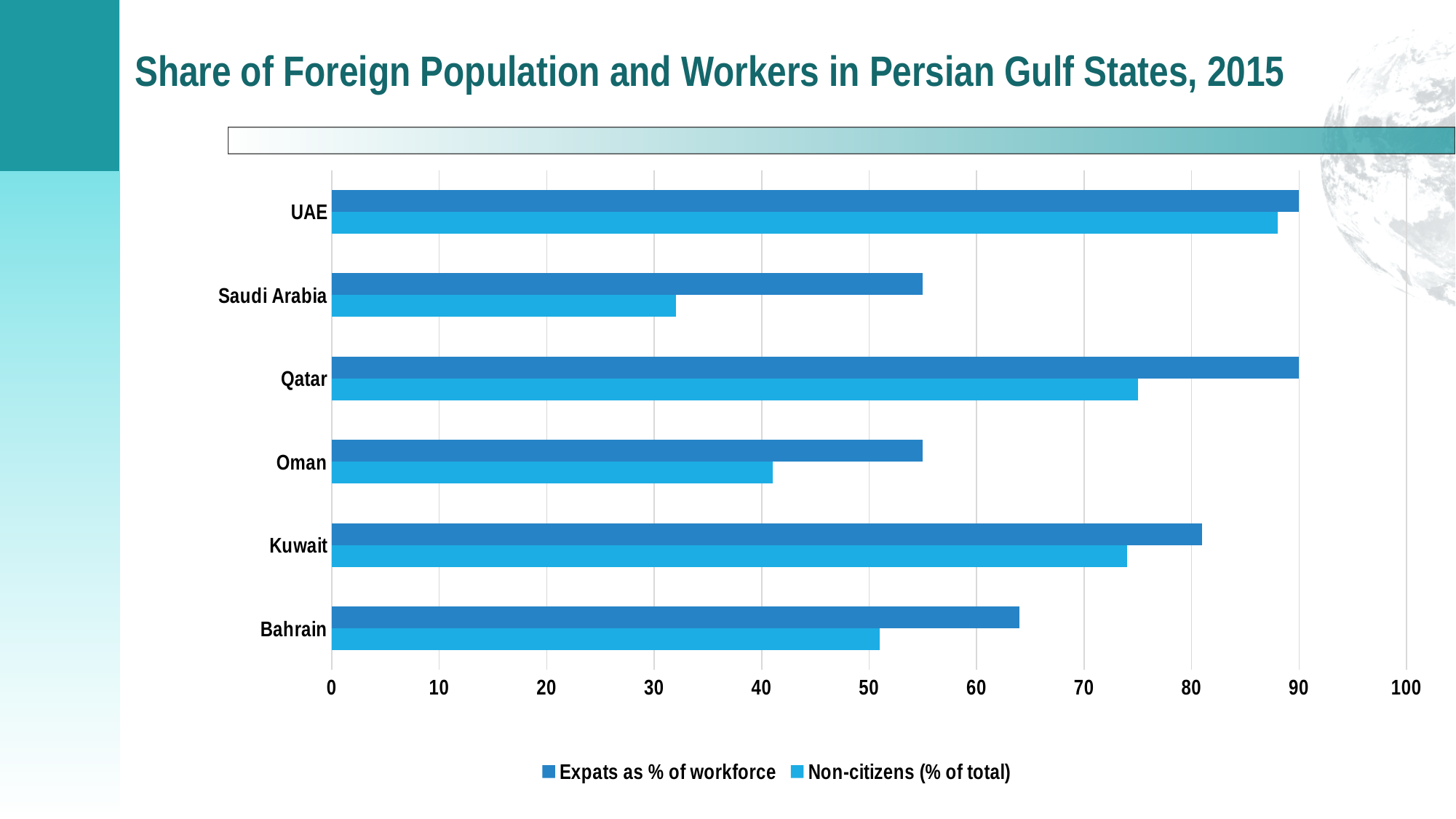
What is the value of Expats as % of workforce for UAE? 90 Which country has the lowest value for Non-citizens (% of total)? Saudi Arabia How many series does the legend list? 2 What is the title of the chart? Share of Foreign Population and Workers in Persian Gulf States, 2015 Is the value of Non-citizens (% of total) for Saudi Arabia greater or less than 40? less Which is larger: Expats as % of workforce for Kuwait or for Bahrain? Kuwait Is the value of Non-citizens (% of total) for Bahrain greater or less than 60? less What type of chart is shown on the slide? Bar chart How many countries are shown on the chart? 6 Which country has the highest value for Non-citizens (% of total)? UAE What is the value of Expats as % of workforce for Qatar? 90